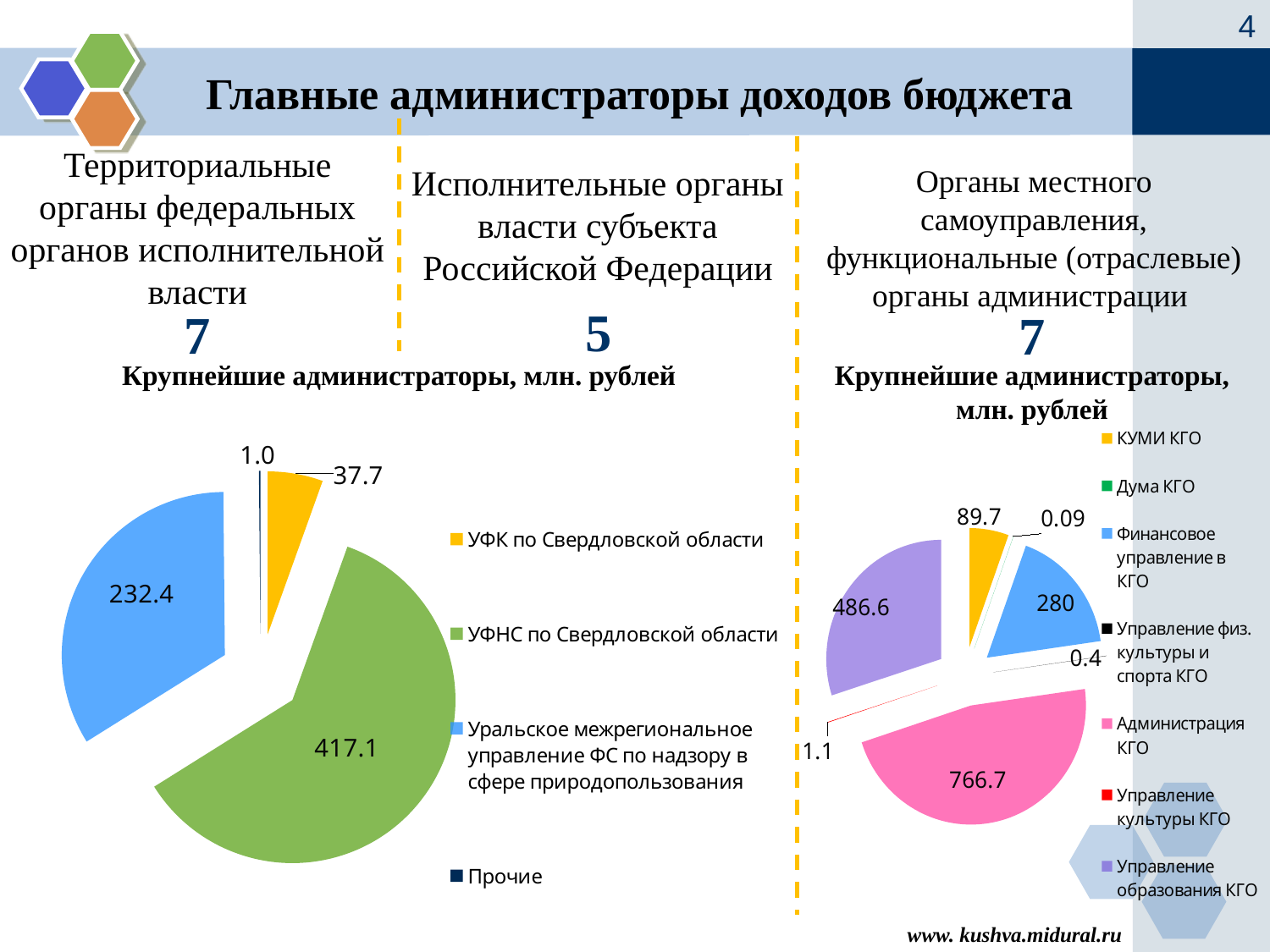
In the right pie chart, what is the value for Финансовое управление в КГО? 280 In the right pie chart, what is the value for Администрация КГО? 766.7 In the right pie chart, which category has the smallest value? Дума КГО In the left pie chart, which category has the largest value? УФНС по Свердловской области How many categories does the legend of the left pie chart list? 4 In the left pie chart, what is the value for Уральское межрегиональное управление ФС по надзору в сфере природопользования? 232.4 In the right pie chart, which is larger: Управление образования КГО or КУМИ КГО? Управление образования КГО How many categories does the legend of the right pie chart list? 7 In the left pie chart, which category has the smallest value? Прочие What type of chart is used on the right side of the slide? Pie chart In the left pie chart, what is the value for УФНС по Свердловской области? 417.1 In the left pie chart, what is the difference between the values for УФНС по Свердловской области and УФК по Свердловской области? 379.4